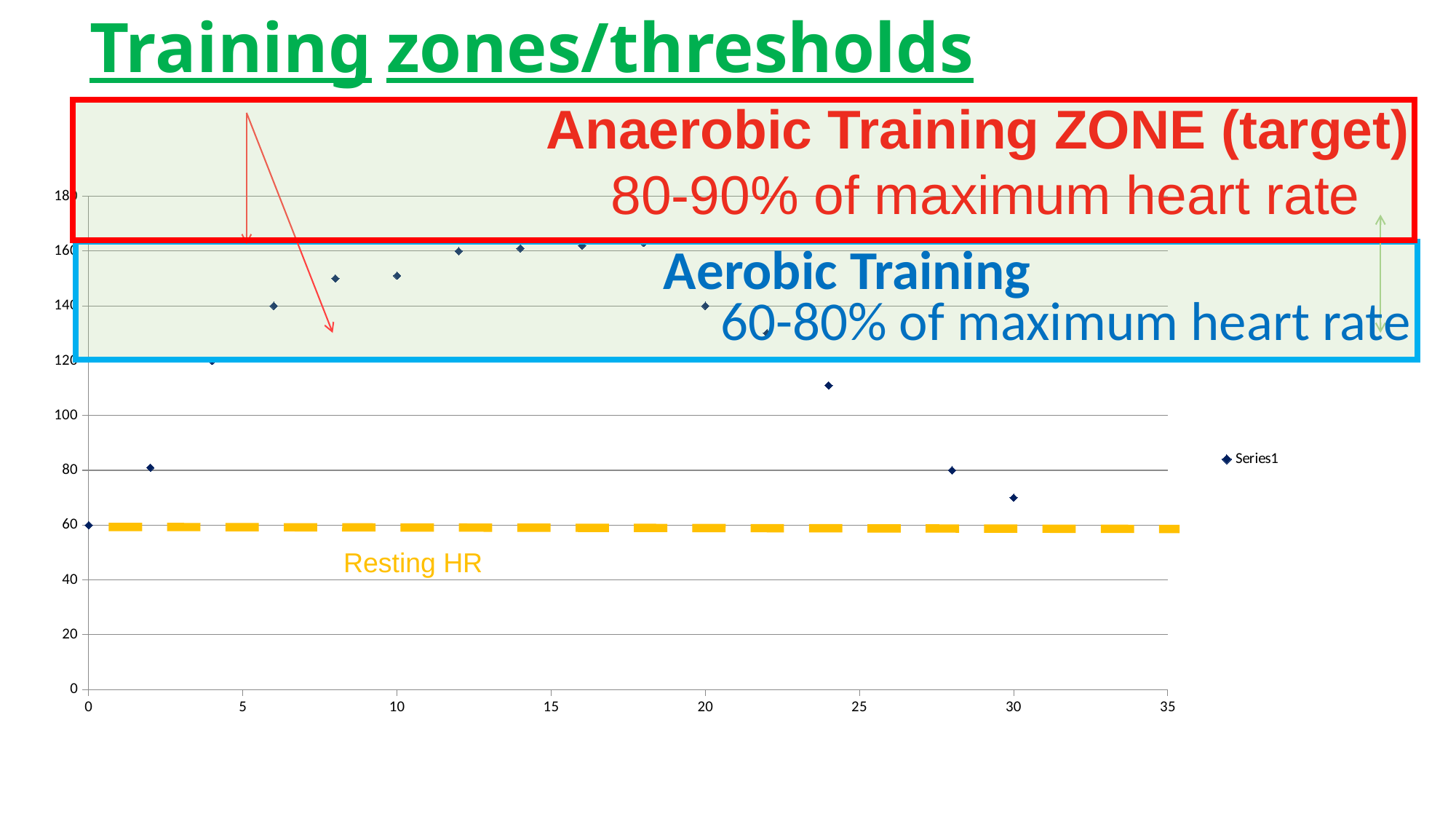
Do the plotted values rise or fall between x = 20 and x = 30? fall What kind of chart is shown on the slide? scatter chart Which point has the lowest value, the one at x = 0 or the one at x = 30? x = 0 Is the value of the point at x = 30 greater or less than 80? less Is the value of the point at x = 8 greater or less than 140? greater What does the dashed yellow horizontal line on the chart represent? Resting HR How many series does the chart legend list? 1 What is the name of the series shown in the chart legend? Series1 Do the plotted values rise or fall between x = 0 and x = 10? rise Which point has the larger value, the one at x = 24 or the one at x = 30? x = 24 Is the value of the point at x = 10 greater or less than 160? less